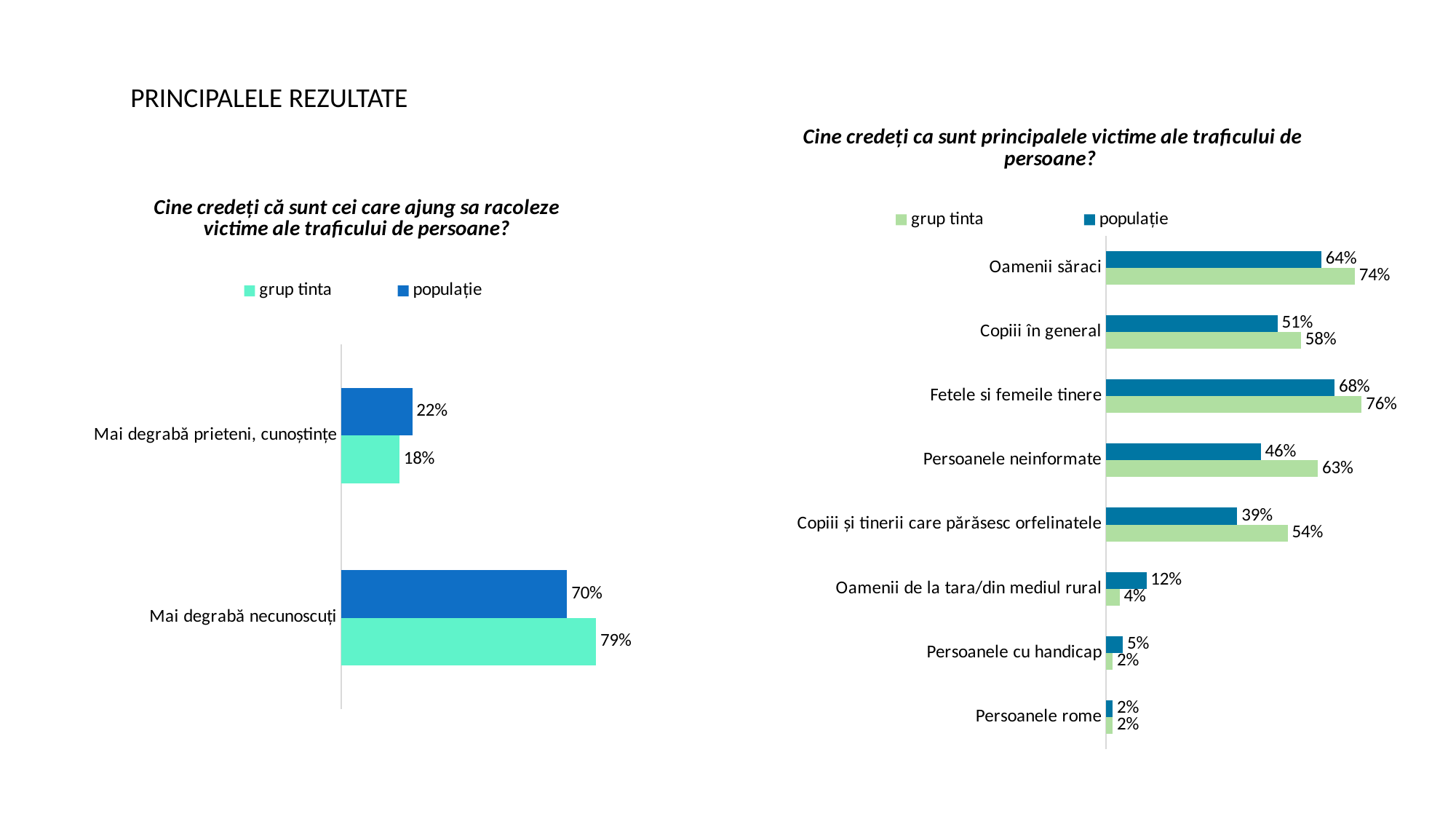
In the right chart (Cine credeți ca sunt principalele victime...), what is the 'grup tinta' value for 'Persoanele neinformate'? 63% In the right chart (Cine credeți ca sunt principalele victime...), what is the difference between the 'grup tinta' and 'populație' values for 'Persoanele neinformate'? 17% In the right chart (Cine credeți ca sunt principalele victime...), how many categories are shown? 8 In the left chart (Cine credeți că sunt cei care ajung sa racoleze victime...), how many categories are shown? 2 In the left chart (Cine credeți că sunt cei care ajung sa racoleze victime...), what is the difference between the 'grup tinta' and 'populație' values for 'Mai degrabă necunoscuți'? 9% In the right chart (Cine credeți ca sunt principalele victime...), which category has the lowest 'populație' value? Persoanele rome In the right chart (Cine credeți ca sunt principalele victime...), which is larger for 'Oamenii de la tara/din mediul rural': the 'grup tinta' value or the 'populație' value? populație In the left chart (Cine credeți că sunt cei care ajung sa racoleze victime...), what is the value for 'populație' for 'Mai degrabă prieteni, cunoștințe'? 22% In the right chart (Cine credeți ca sunt principalele victime...), which category has the highest 'grup tinta' value? Fetele si femeile tinere In the left chart (Cine credeți că sunt cei care ajung sa racoleze victime...), what is the value for 'grup tinta' for 'Mai degrabă necunoscuți'? 79% In the right chart (Cine credeți ca sunt principalele victime...), what is the 'populație' value for 'Copiii și tinerii care părăsesc orfelinatele'? 39% How many series does the legend of the right chart (Cine credeți ca sunt principalele victime...) list? 2